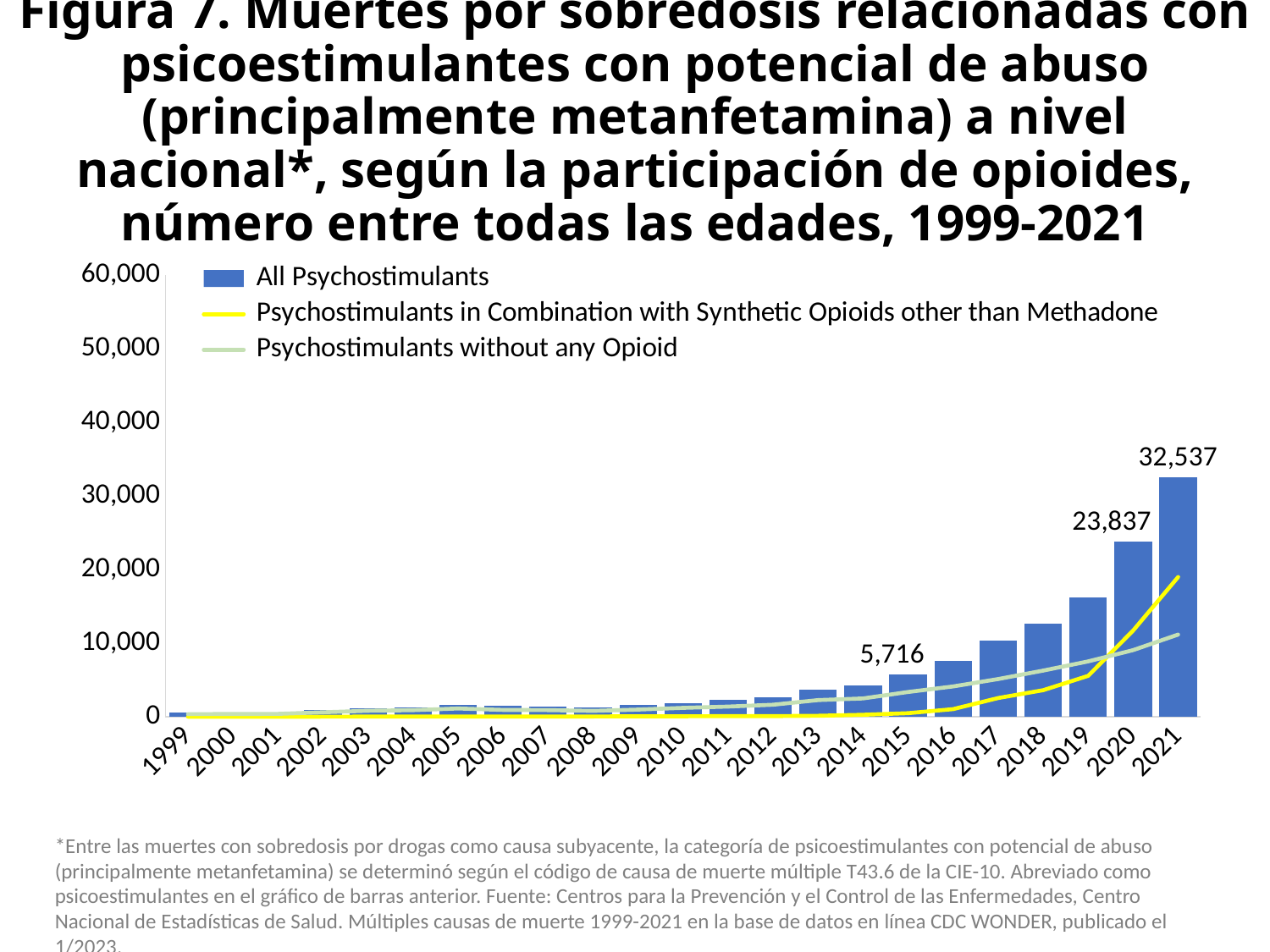
Is the All Psychostimulants value for 2018 greater or less than 10,000? greater Which is larger, the All Psychostimulants value for 2019 or for 2016? 2019 Do the All Psychostimulants values generally rise or fall from 1999 to 2021? rise What is the difference between the All Psychostimulants values for 2021 and 2020? 8,700 How many years are shown on the x axis? 23 How many series does the legend list? 3 What is the value for All Psychostimulants in 2020? 23,837 Which year has the highest value for All Psychostimulants? 2021 What is the value for All Psychostimulants in 2021? 32,537 What is the difference between the All Psychostimulants values for 2020 and 2015? 18,121 What is the value for All Psychostimulants in 2015? 5,716 Is the All Psychostimulants value for 2013 greater or less than 10,000? less